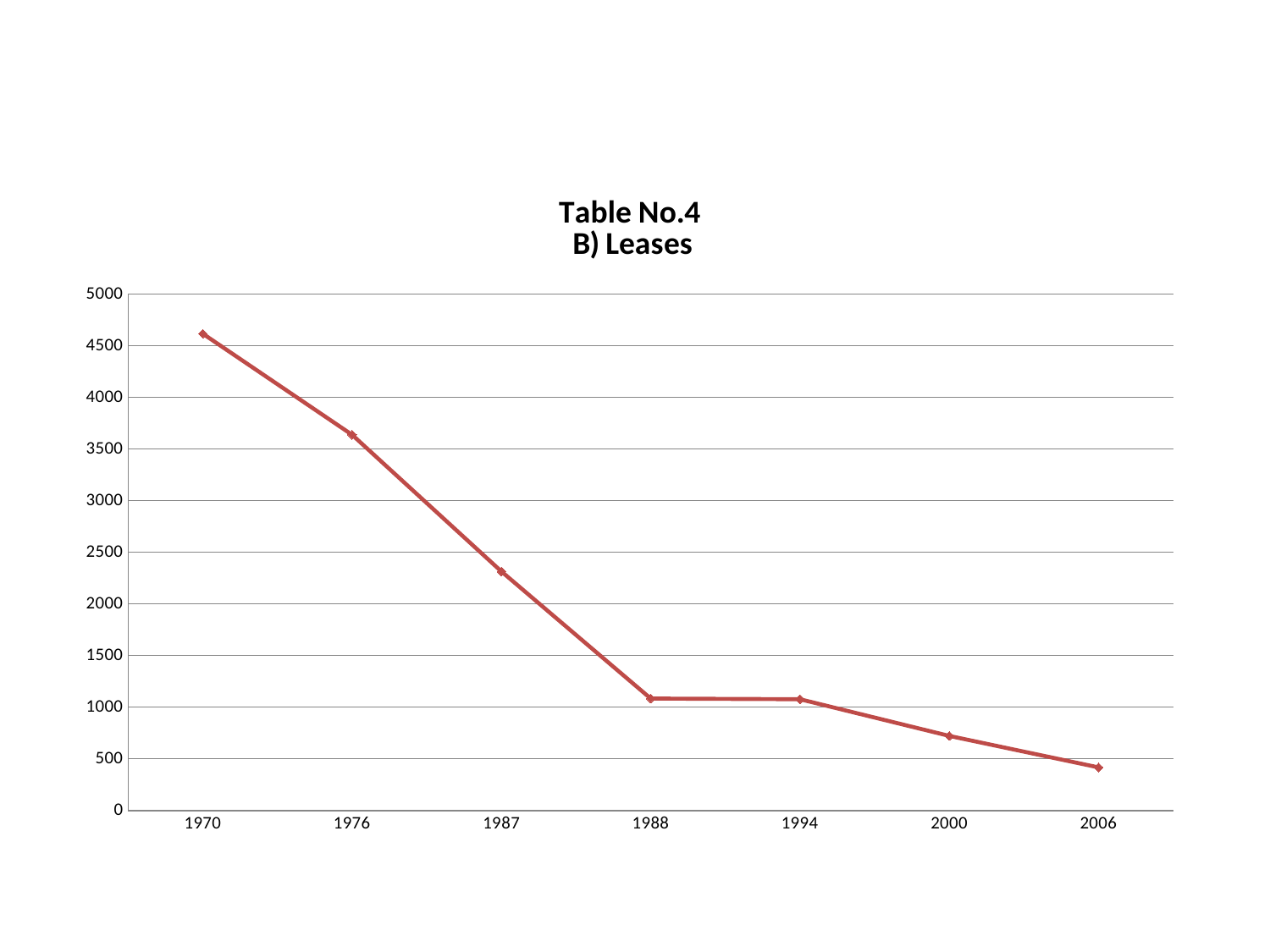
What is the title of the chart? Table No.4 B) Leases Is the value for 2000 greater or less than 1000? less Which year has the highest value? 1970 Is the value for 2006 greater or less than 500? less Which year has the lowest value? 2006 Which is larger, the value for 1976 or the value for 1987? 1976 Is the value for 1970 greater or less than 4500? greater Do the values generally rise or fall from 1970 to 2006? fall How many years are plotted on the x axis? 7 What kind of chart is shown on the slide? line chart